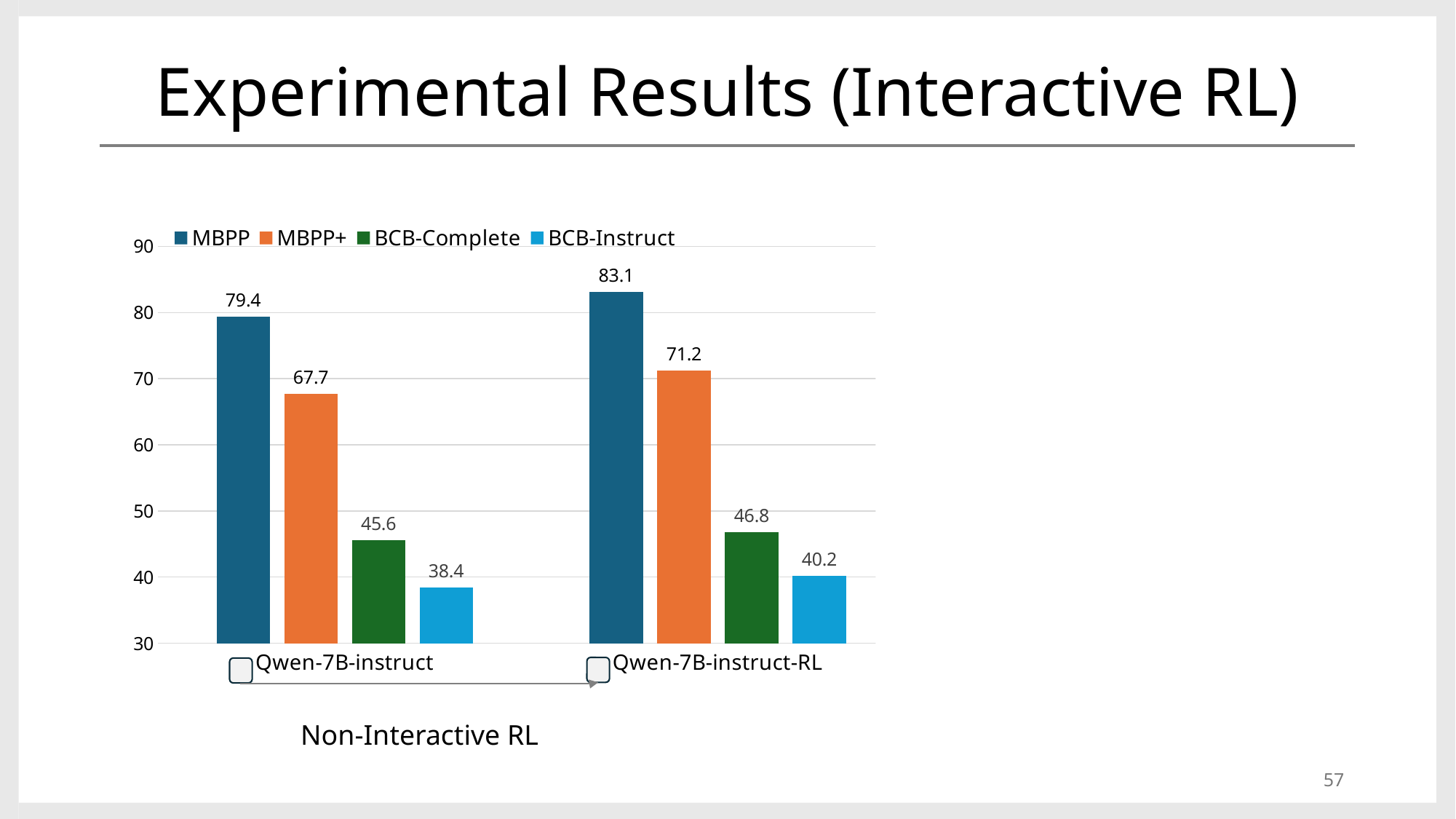
How many series does the legend list? 4 What is the MBPP+ value for Qwen-7B-instruct-RL? 71.2 How many categories are shown on the x axis? 2 What is the BCB-Complete value for Qwen-7B-instruct-RL? 46.8 Which is larger, the BCB-Instruct value for Qwen-7B-instruct or for Qwen-7B-instruct-RL? Qwen-7B-instruct-RL What is the BCB-Instruct value for Qwen-7B-instruct? 38.4 Which series has the highest value for Qwen-7B-instruct-RL? MBPP What is the MBPP value for Qwen-7B-instruct? 79.4 Which series has the lowest value for Qwen-7B-instruct? BCB-Instruct What kind of chart is shown on the slide? Bar chart What is the difference between the MBPP+ values for Qwen-7B-instruct-RL and Qwen-7B-instruct? 3.5 What is the difference between the MBPP values for Qwen-7B-instruct-RL and Qwen-7B-instruct? 3.7